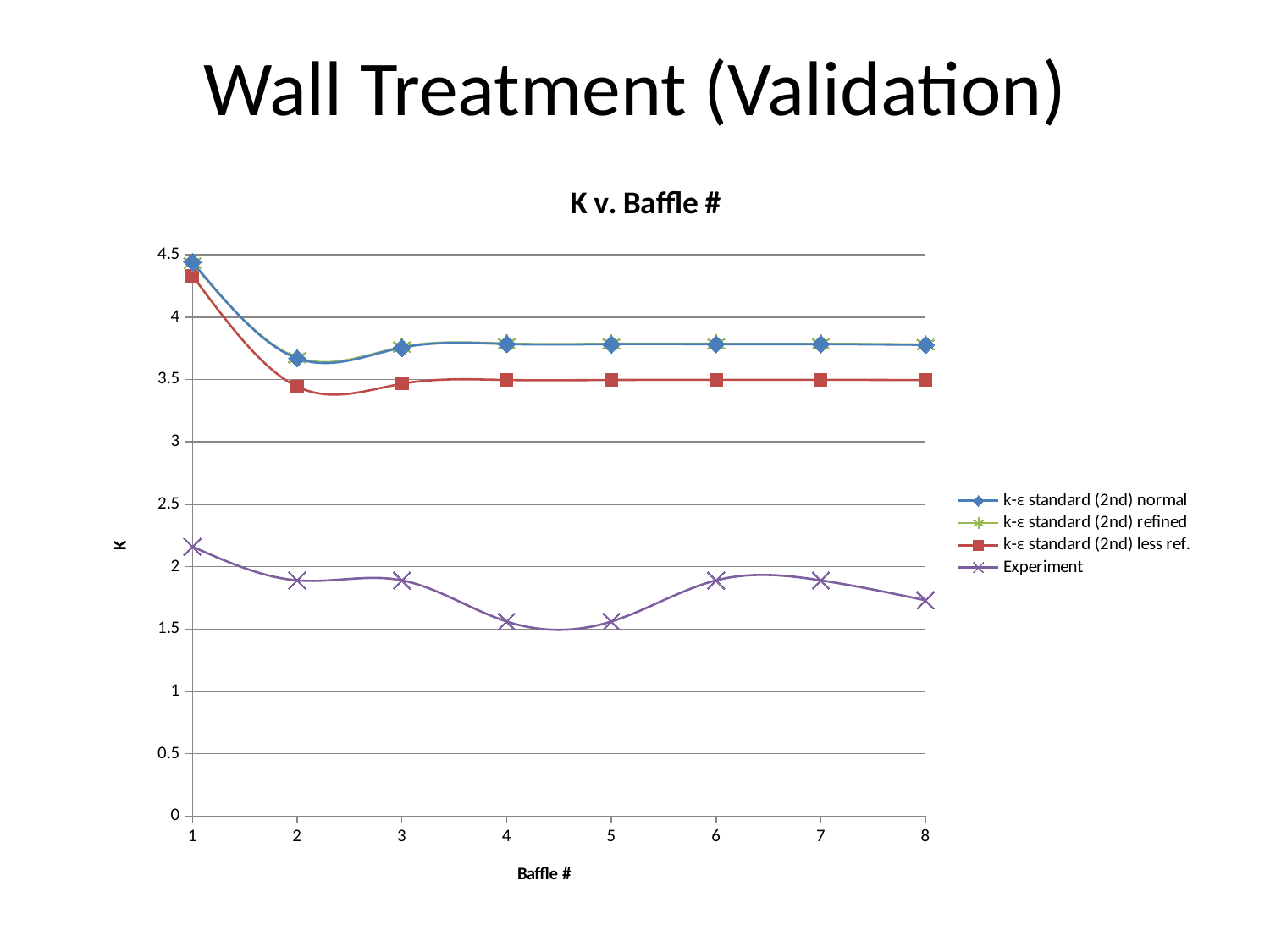
What is the label of the x axis? Baffle # For the Experiment series, at which baffle number is K highest? 1 How many baffle numbers are plotted along the x axis? 8 How many series does the legend list? 4 Is the Experiment value at baffle 4 greater or less than 2? less At baffle 1, which is larger: k-ε standard (2nd) normal or Experiment? k-ε standard (2nd) normal What kind of chart is shown on the slide? line chart Is the k-ε standard (2nd) normal value at baffle 2 greater or less than 3.5? greater What is the title of the chart? K v. Baffle # Is the Experiment value at baffle 1 greater or less than 2? greater Does the Experiment series rise or fall from baffle 1 to baffle 2? fall